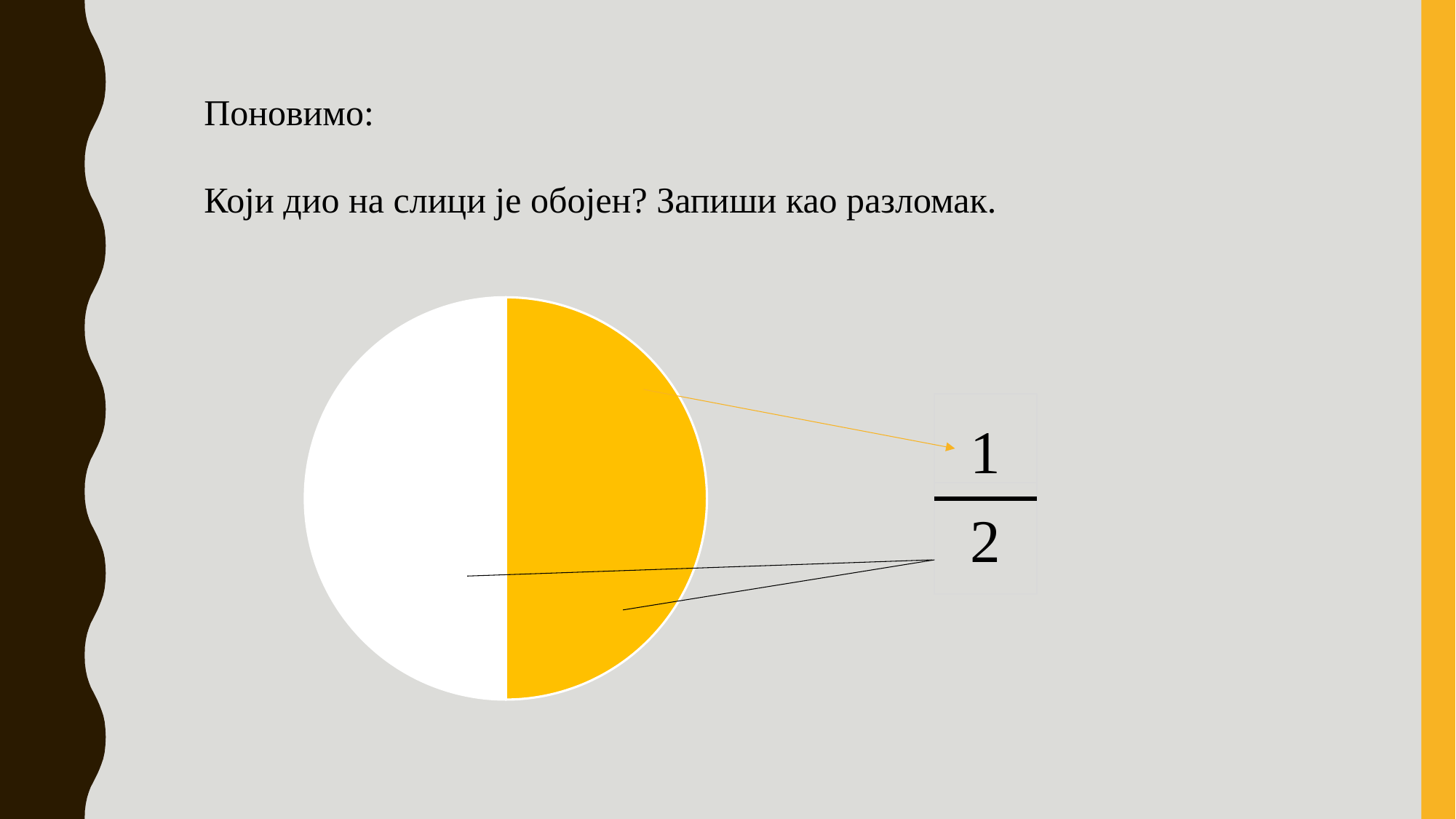
What is the numerator of the fraction shown next to the pie chart? 1 What kind of chart is shown on the slide? pie chart What fraction of the pie chart is coloured, as written on the slide? 1/2 What colour is the shaded half of the pie chart? yellow How many slices does the pie chart have? 2